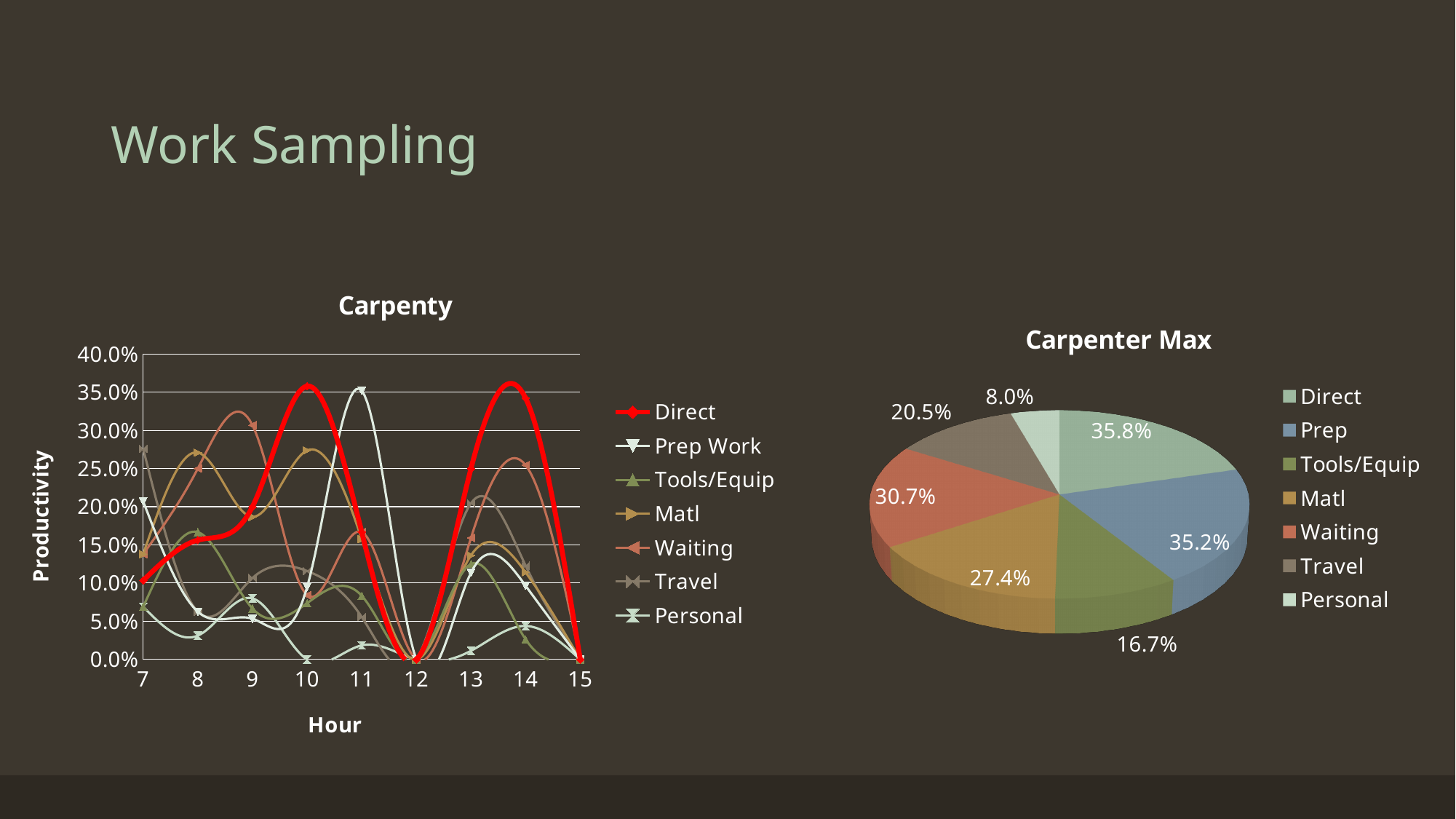
On the Carpenter Max pie chart, what value is shown for Waiting? 30.7% On the Carpenter Max pie chart, what is the difference between the Waiting value and the Travel value? 10.2% How many series does the legend of the Carpenty chart list? 7 On the Carpenter Max pie chart, what value is shown for Personal? 8.0% What kind of chart is the Carpenty chart? line chart On the Carpenter Max pie chart, what value is shown for Matl? 27.4% On the Carpenter Max pie chart, what value is shown for Tools/Equip? 16.7% On the Carpenter Max pie chart, which category has the smallest value? Personal How many hours are plotted along the x axis of the Carpenty chart? 9 On the Carpenter Max pie chart, which is larger, Matl or Tools/Equip? Matl On the Carpenty chart, is the Direct value at hour 14 greater or less than 30.0%? greater On the Carpenter Max pie chart, which category has the largest value? Direct